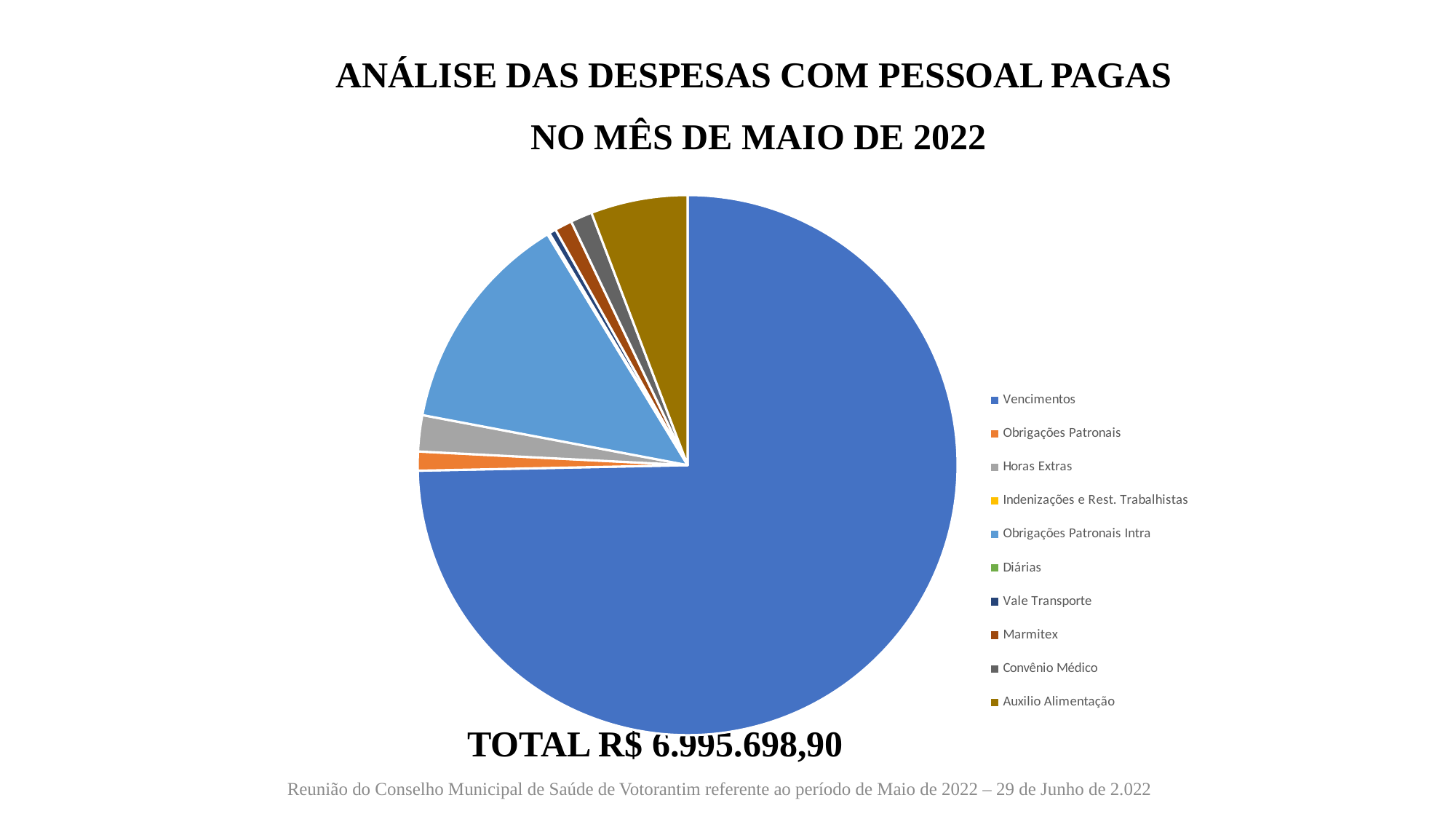
Does the Vencimentos slice account for more or less than half of the pie? more Which category has the largest slice of the pie chart? Vencimentos What total amount is printed below the pie chart? R$ 6.995.698,90 What kind of chart is shown on the slide? pie chart Which slice is larger, Auxilio Alimentação or Convênio Médico? Auxilio Alimentação Which slice is larger, Vencimentos or Obrigações Patronais Intra? Vencimentos Which slice is larger, Obrigações Patronais Intra or Horas Extras? Obrigações Patronais Intra How many entries does the legend of the pie chart list? 10 Which month and year does the chart title say the personnel expenses refer to? Maio de 2022